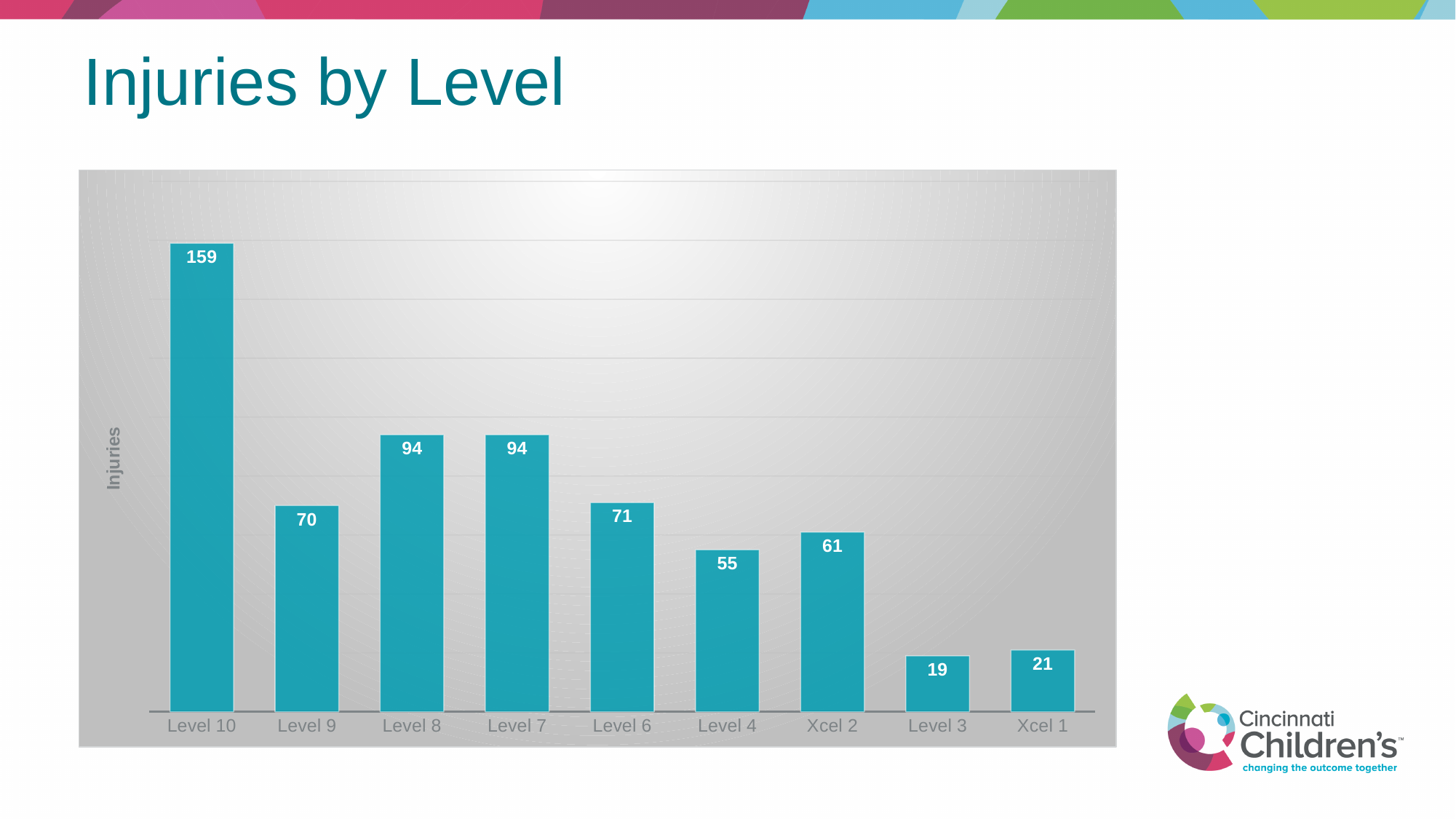
What is the number of injuries for Level 6? 71 Which has more injuries, Level 6 or Level 4? Level 6 How many levels are shown on the x axis of the chart? 9 What is the label on the vertical axis of the chart? Injuries How many injuries are shown for Level 10? 159 Which level has the highest number of injuries? Level 10 What is the difference in injuries between Xcel 1 and Level 3? 2 What is the difference in injuries between Level 10 and Level 9? 89 Which has more injuries, Xcel 2 or Level 9? Level 9 Which level has the lowest number of injuries? Level 3 What is the number of injuries for Xcel 2? 61 What kind of chart is shown on the slide? Bar chart